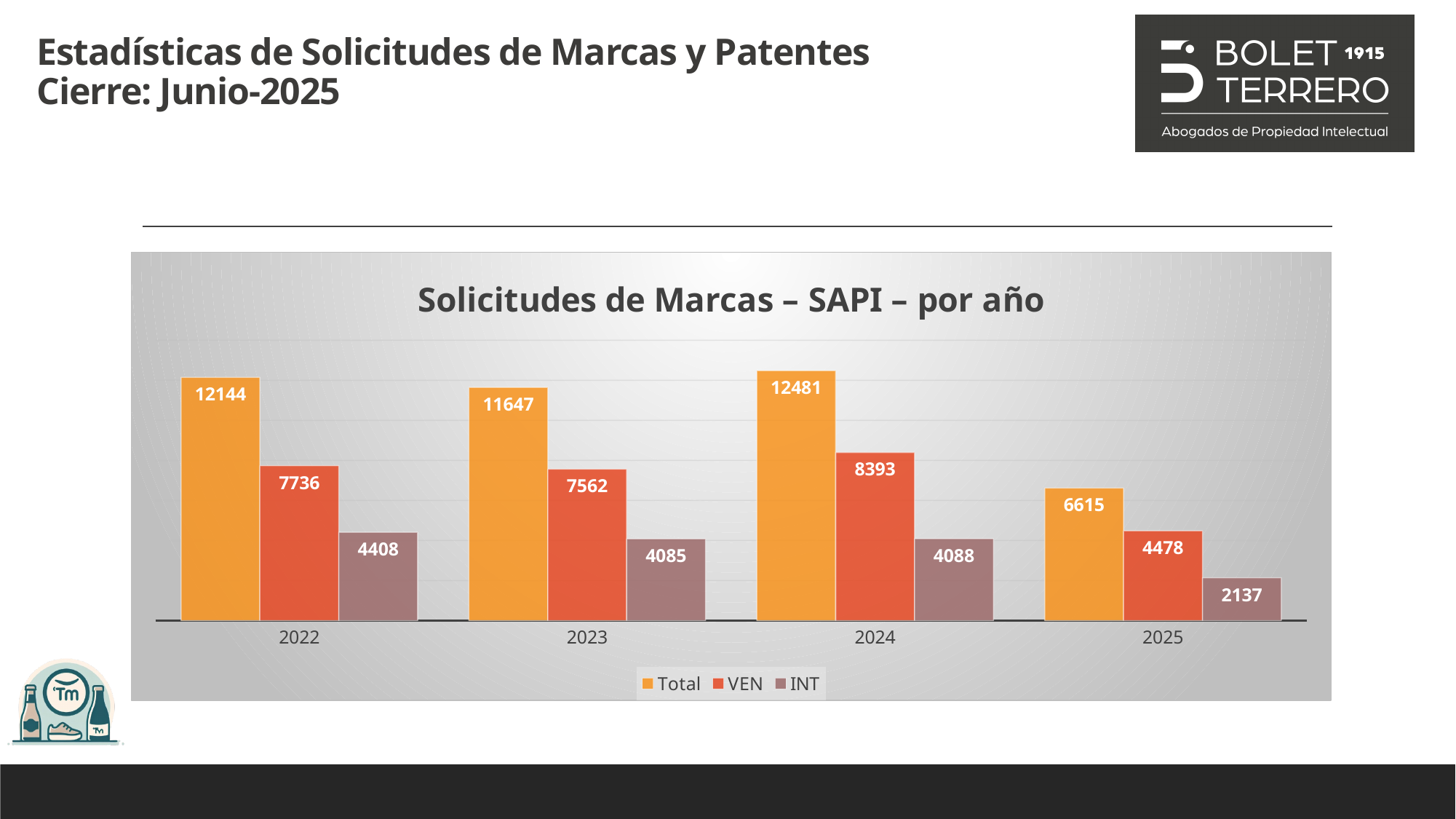
How many years are shown on the x axis? 4 What is the difference between the VEN values for 2024 and 2023? 831 What is the Total value for 2024? 12481 Which year has the lowest INT value? 2025 How many series does the legend list? 3 What is the INT value for 2025? 2137 What is the VEN value for 2022? 7736 What kind of chart is shown on the slide? Bar chart Which is larger, the INT value for 2022 or the INT value for 2023? 2022 Does the VEN value rise or fall from 2024 to 2025? Fall What is the title of the chart? Solicitudes de Marcas – SAPI – por año Which year has the highest Total value? 2024